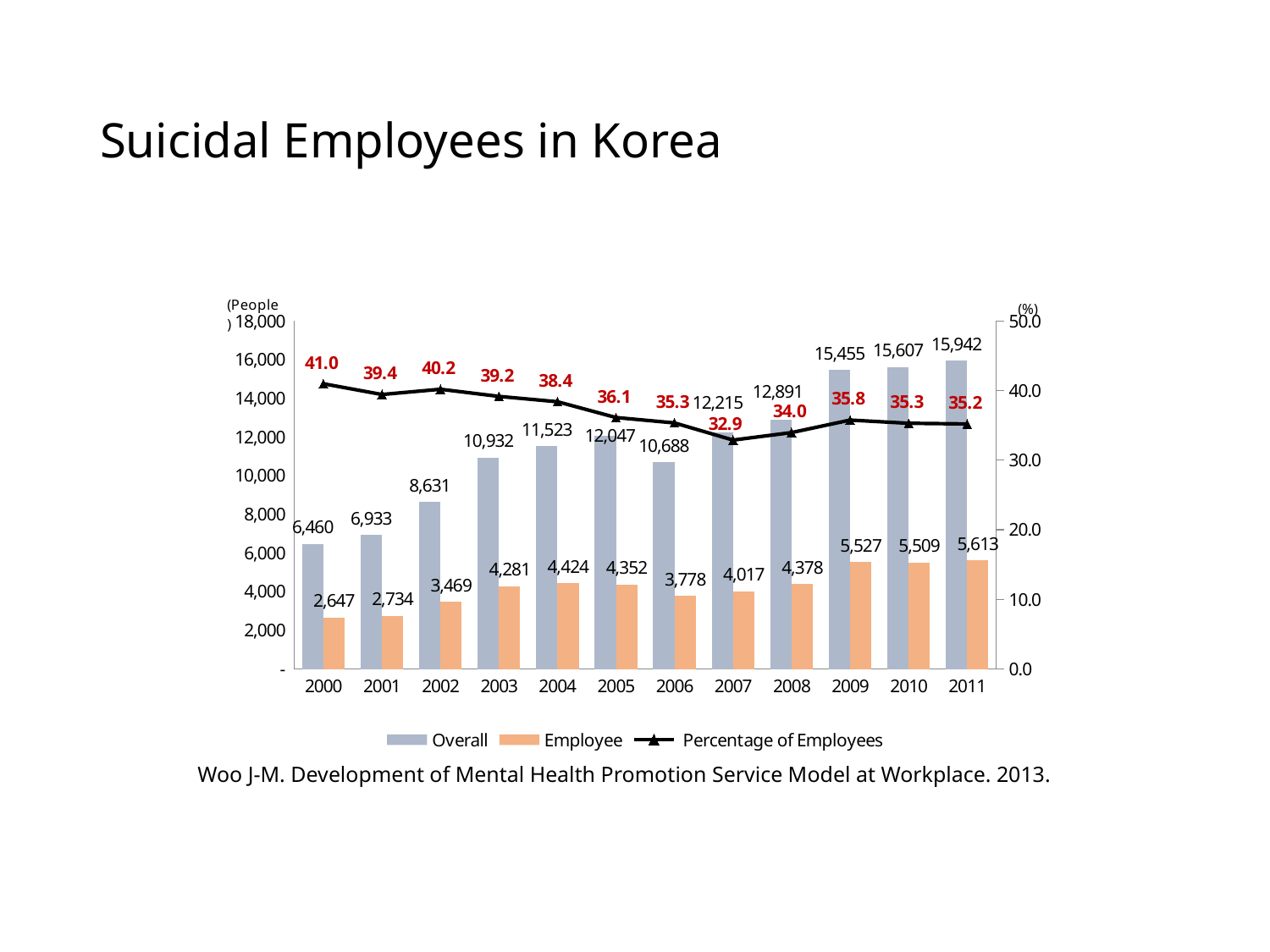
What is the Employee value for 2009? 5,527 Which is larger, the Employee value for 2005 or the Employee value for 2006? 2005 Does the Percentage of Employees line generally rise or fall from 2000 to 2011? Fall In which year is the Percentage of Employees lowest? 2007 How many years are shown on the x axis? 12 What is the Overall value for 2003? 10,932 What is the title of the chart? Suicidal Employees in Korea What is the difference between the Overall value and the Employee value in 2011? 10,329 How many series does the legend list? 3 What is the Percentage of Employees for 2007? 32.9 What kind of chart is this? Combined bar and line chart In which year is the Overall value highest? 2011